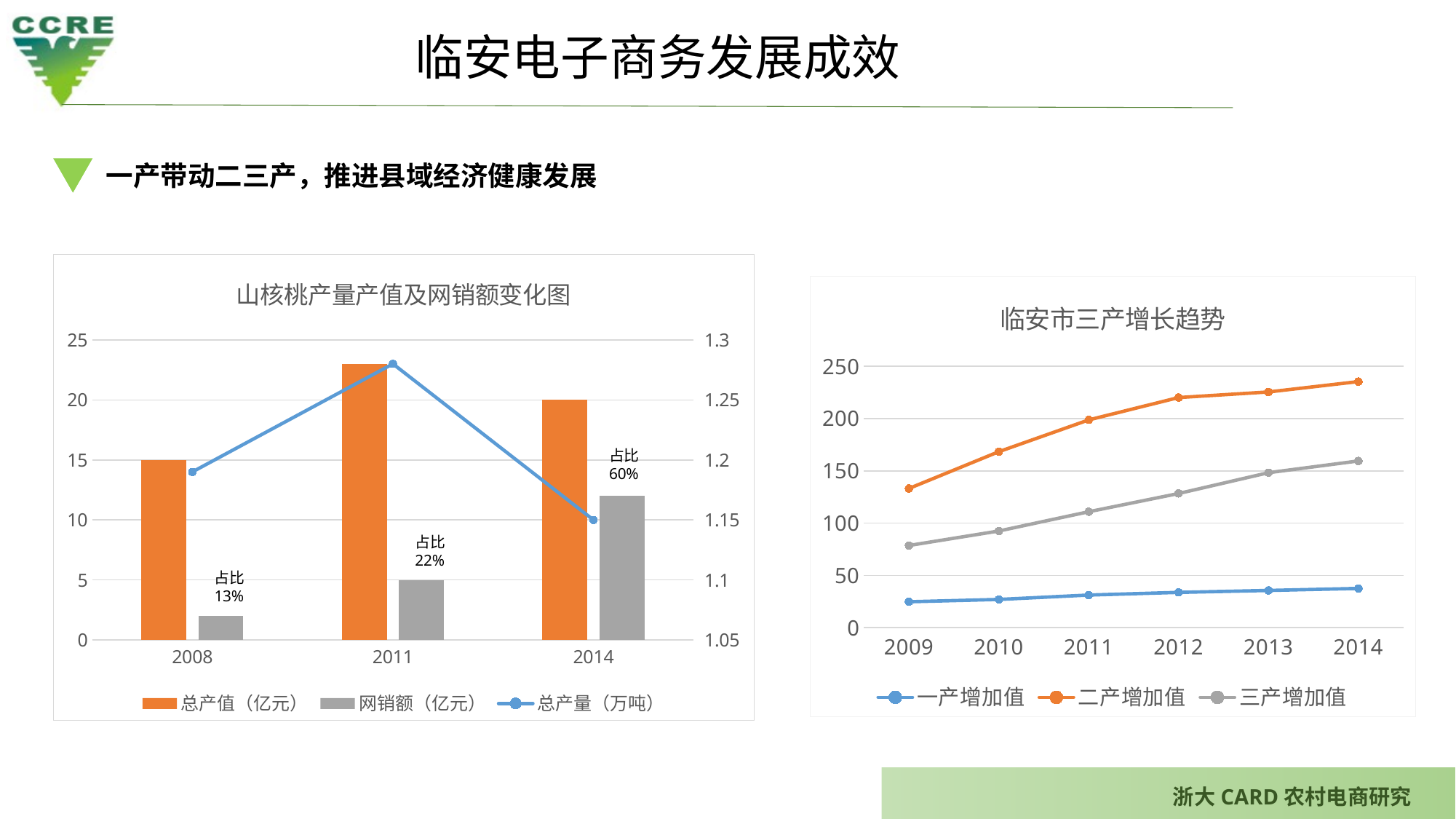
In the chart titled 临安市三产增长趋势, how many years are shown on the x axis? 6 In the chart titled 临安市三产增长趋势, does 二产增加值 rise or fall from 2009 to 2014? rise In the chart titled 山核桃产量产值及网销额变化图, which year has the highest 网销额（亿元）? 2014 In the chart titled 山核桃产量产值及网销额变化图, what is the 总产值（亿元） value for 2008? 15 In the chart titled 临安市三产增长趋势, is the value for 三产增加值 in 2014 greater or less than 150? greater In the chart titled 山核桃产量产值及网销额变化图, what is the 占比 label shown for 2008? 13% In the chart titled 临安市三产增长趋势, what kind of chart is it? line chart In the chart titled 山核桃产量产值及网销额变化图, which year has the highest 总产量（万吨）? 2011 In the chart titled 山核桃产量产值及网销额变化图, how many series does the legend list? 3 In the chart titled 临安市三产增长趋势, which series has the highest value in 2014? 二产增加值 In the chart titled 山核桃产量产值及网销额变化图, what is the 占比 label shown for 2014? 60%